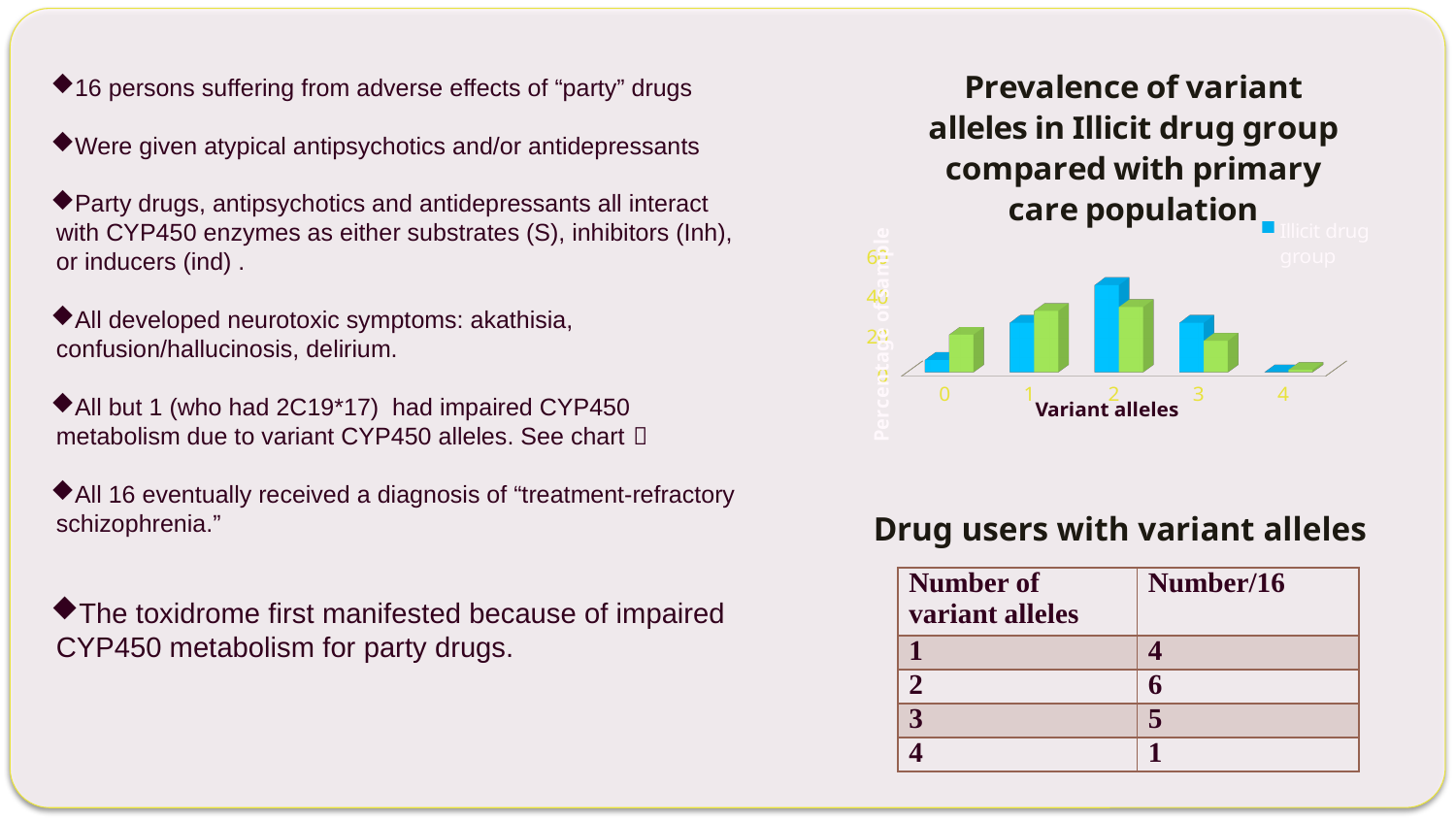
For the Illicit drug group series, which number of variant alleles has the lowest bar? 4 In the Illicit drug group series, is the bar for 2 variant alleles larger or smaller than the bar for 0 variant alleles? larger What kind of chart is shown on the slide? bar chart In the Illicit drug group series, is the bar for 1 variant allele larger or smaller than the bar for 4 variant alleles? larger How many variant allele categories are shown on the x axis of the chart? 5 Is the Illicit drug group value for 0 variant alleles greater or less than 20? less Is the Illicit drug group value for 4 variant alleles greater or less than 20? less What is the label of the x axis of the chart? Variant alleles Is the Illicit drug group value for 2 variant alleles greater or less than 20? greater What is the title of the chart? Prevalence of variant alleles in Illicit drug group compared with primary care population For the Illicit drug group series, which number of variant alleles has the highest bar? 2